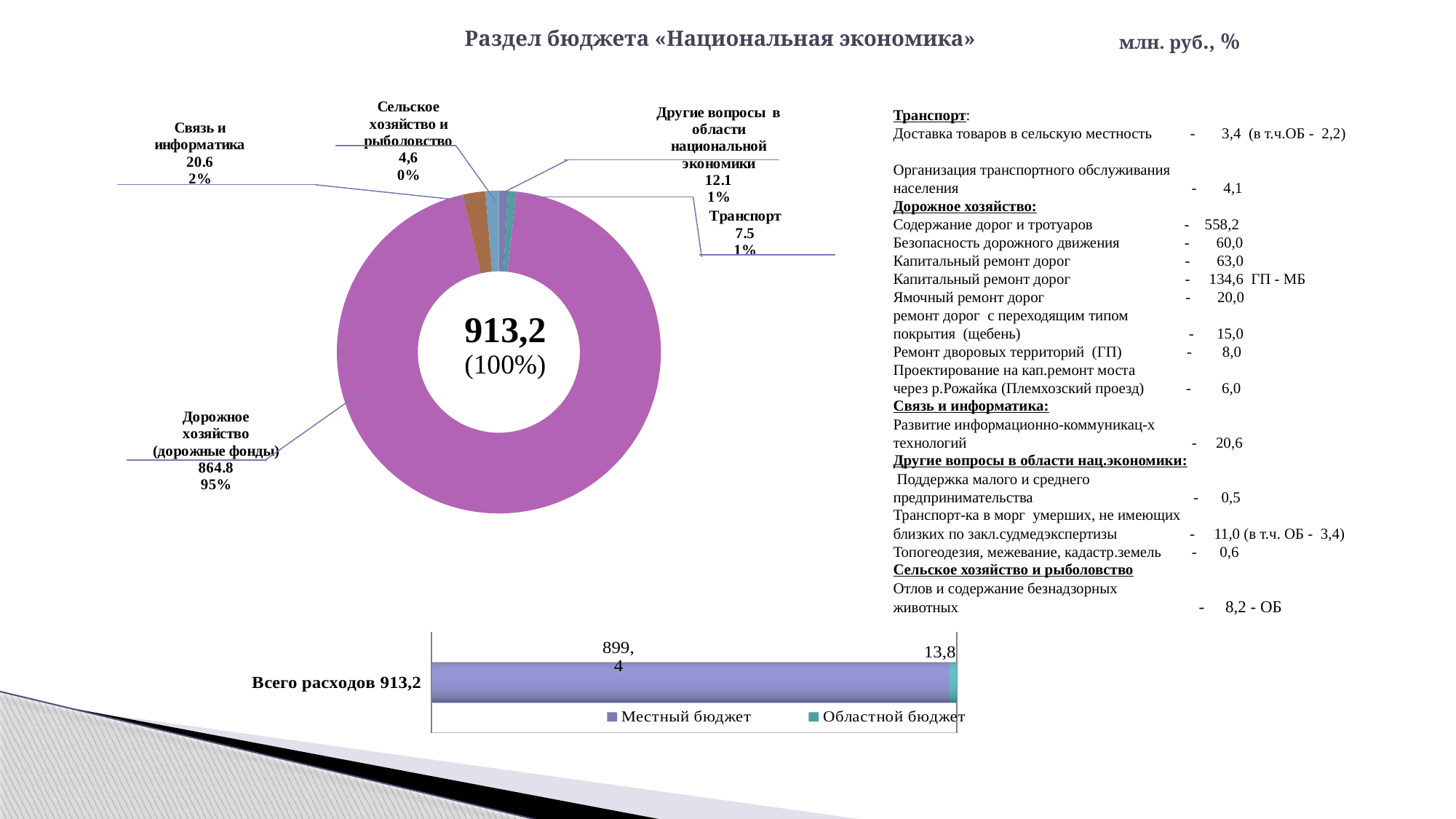
In the donut chart, what value is shown for Дорожное хозяйство (дорожные фонды)? 864.8 In the donut chart, what value is shown for Транспорт? 7.5 In the donut chart, which category has the largest value? Дорожное хозяйство (дорожные фонды) What total value is printed in the centre of the donut chart? 913,2 In the bar chart at the bottom of the slide, what value is shown for Местный бюджет? 899,4 In the donut chart, what percentage share is shown for Дорожное хозяйство (дорожные фонды)? 95% In the donut chart, which is larger: Связь и информатика or Другие вопросы в области национальной экономики? Связь и информатика How many categories does the donut chart show? 5 In the donut chart, what value is shown for Связь и информатика? 20.6 In the bar chart at the bottom of the slide, what value is shown for Областной бюджет? 13,8 In the donut chart, what percentage share is shown for Связь и информатика? 2%